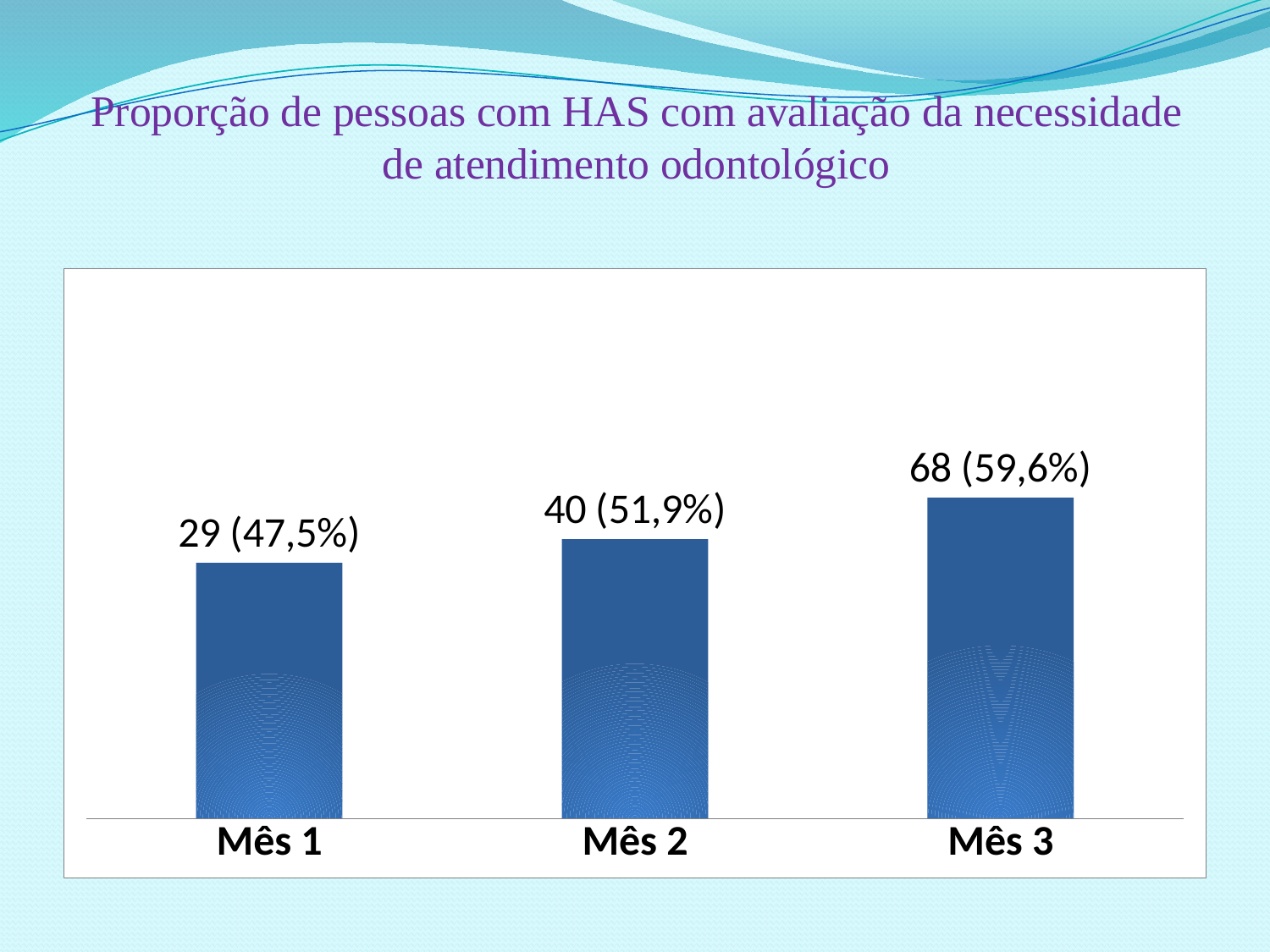
Which month has the lowest bar? Mês 1 Which is larger, the value for Mês 2 or the value for Mês 3? Mês 3 How many months (categories) are shown in the chart? 3 What is the data label shown for Mês 1? 29 (47,5%) Which month has the highest bar? Mês 3 What percentage is shown for Mês 3? 59,6% What is the difference between the counts for Mês 2 and Mês 1? 11 What is the data label shown for Mês 3? 68 (59,6%) Do the values rise or fall from Mês 1 to Mês 3? Rise What is the data label shown for Mês 2? 40 (51,9%) What is the difference between the counts for Mês 3 and Mês 1? 39 What kind of chart is shown on the slide? Bar chart